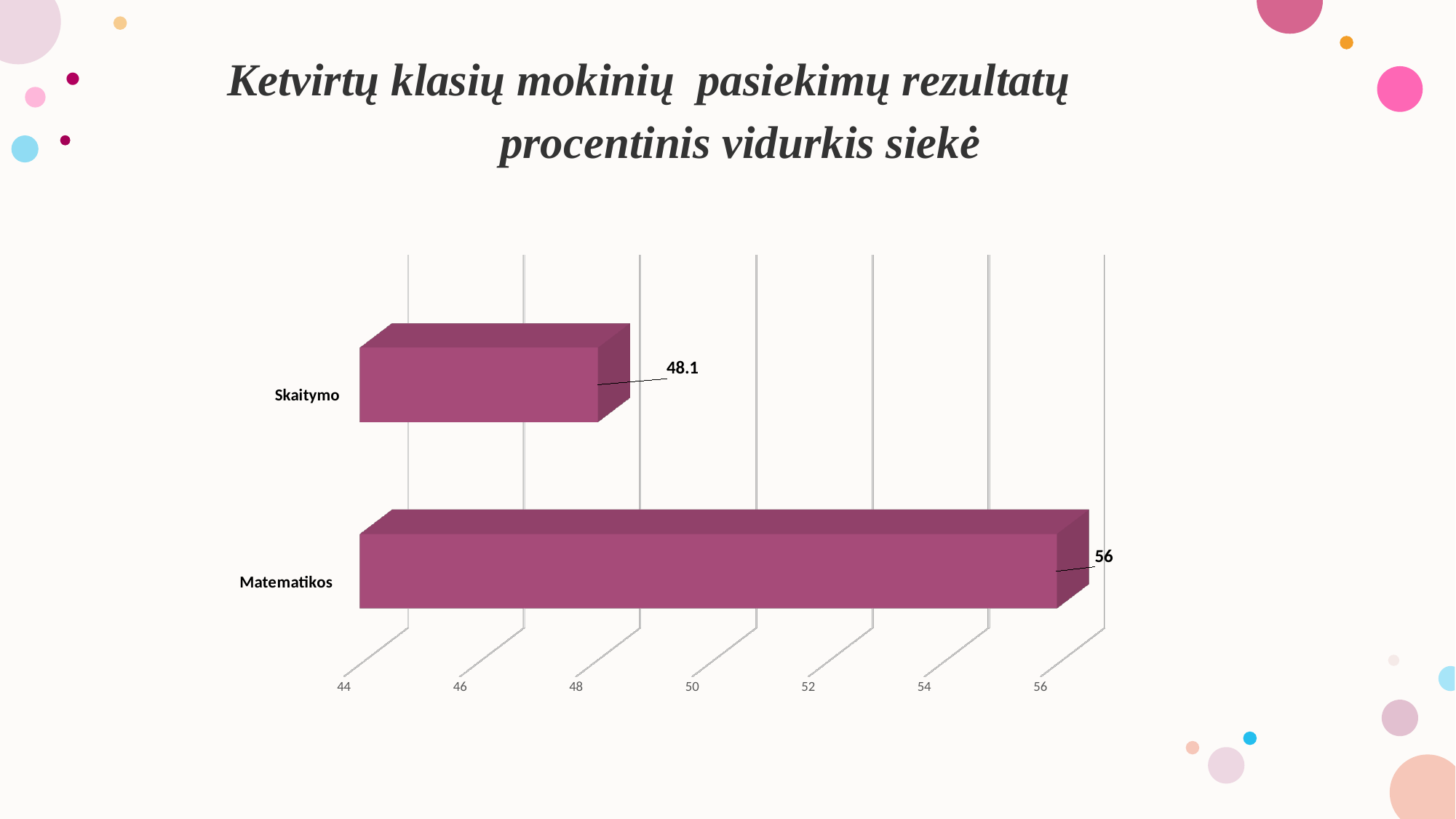
Which category has the highest value? Matematikos How many categories are shown in the chart? 2 What is the lowest value shown on the horizontal axis? 44 What is the difference between the values for Matematikos and Skaitymo? 7.9 What kind of chart is shown on the slide? bar chart What is the value for Skaitymo? 48.1 Is the value for Skaitymo greater or less than 50? less What is the value for Matematikos? 56 Is the value for Matematikos greater or less than 54? greater Which is larger, the value for Skaitymo or the value for Matematikos? Matematikos What is the highest value shown on the horizontal axis? 56 Which category has the lowest value? Skaitymo